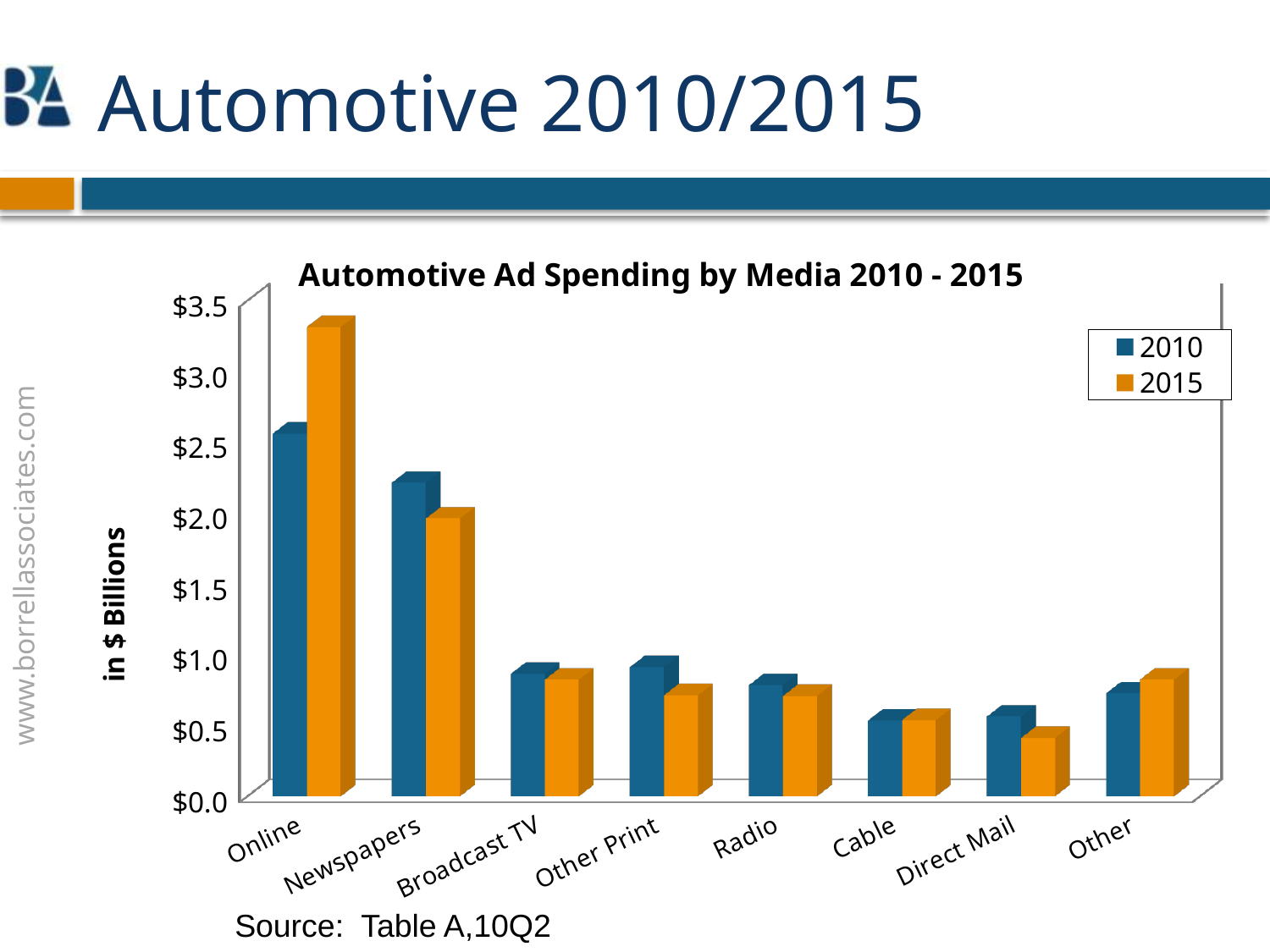
How many media categories are shown on the x axis of the chart? 8 Which media category has the highest 2015 bar? Online Is the 2015 value for Online greater or less than $3.0? greater Is the 2010 value for Broadcast TV greater or less than $1.0? less How many series does the chart's legend list? 2 What kind of chart is shown on the slide? Bar chart For Online, which is larger: the 2010 value or the 2015 value? 2015 Which media category has the lowest 2015 bar? Direct Mail For Newspapers, which is larger: the 2010 value or the 2015 value? 2010 Which media category has the highest 2010 bar? Online Is the 2015 value for Direct Mail greater or less than $0.5? less What is the title of the chart? Automotive Ad Spending by Media 2010 - 2015